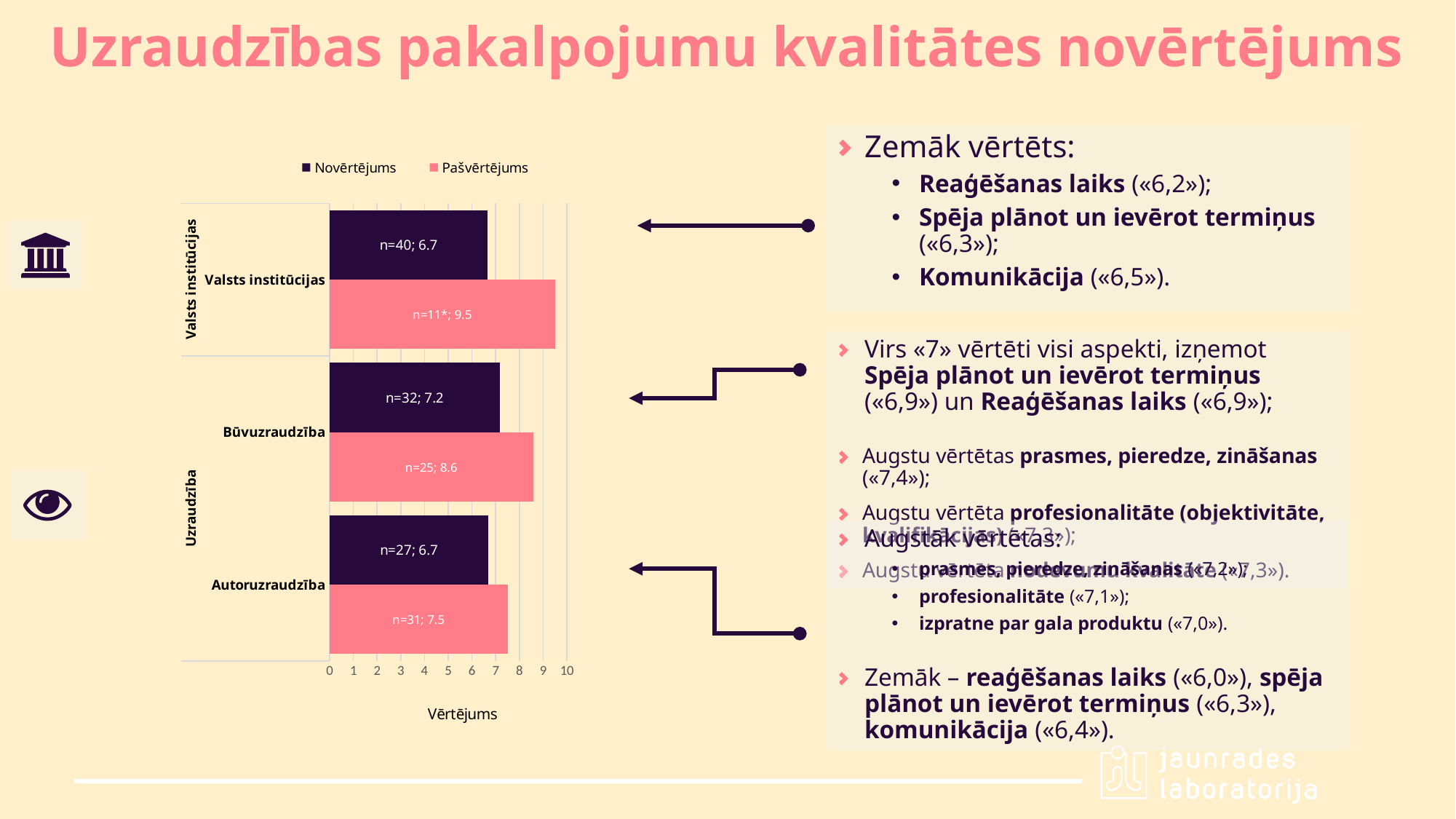
What type of chart is shown on the slide? bar chart What is the Pašvērtējums value for Būvuzraudzība? 8.6 What is the Novērtējums value for Autoruzraudzība? 6.7 Which category has the highest Novērtējums value? Būvuzraudzība What is the difference between the Pašvērtējums and Novērtējums values for Valsts institūcijas? 2.8 Which is larger for Būvuzraudzība, the Novērtējums value or the Pašvērtējums value? Pašvērtējums What is the title of the horizontal axis of the chart? Vērtējums Which category has the highest Pašvērtējums value? Valsts institūcijas How many categories are shown on the chart? 3 How many series does the chart legend list? 2 What is the Pašvērtējums value for Valsts institūcijas? 9.5 What is the Novērtējums value for Valsts institūcijas? 6.7